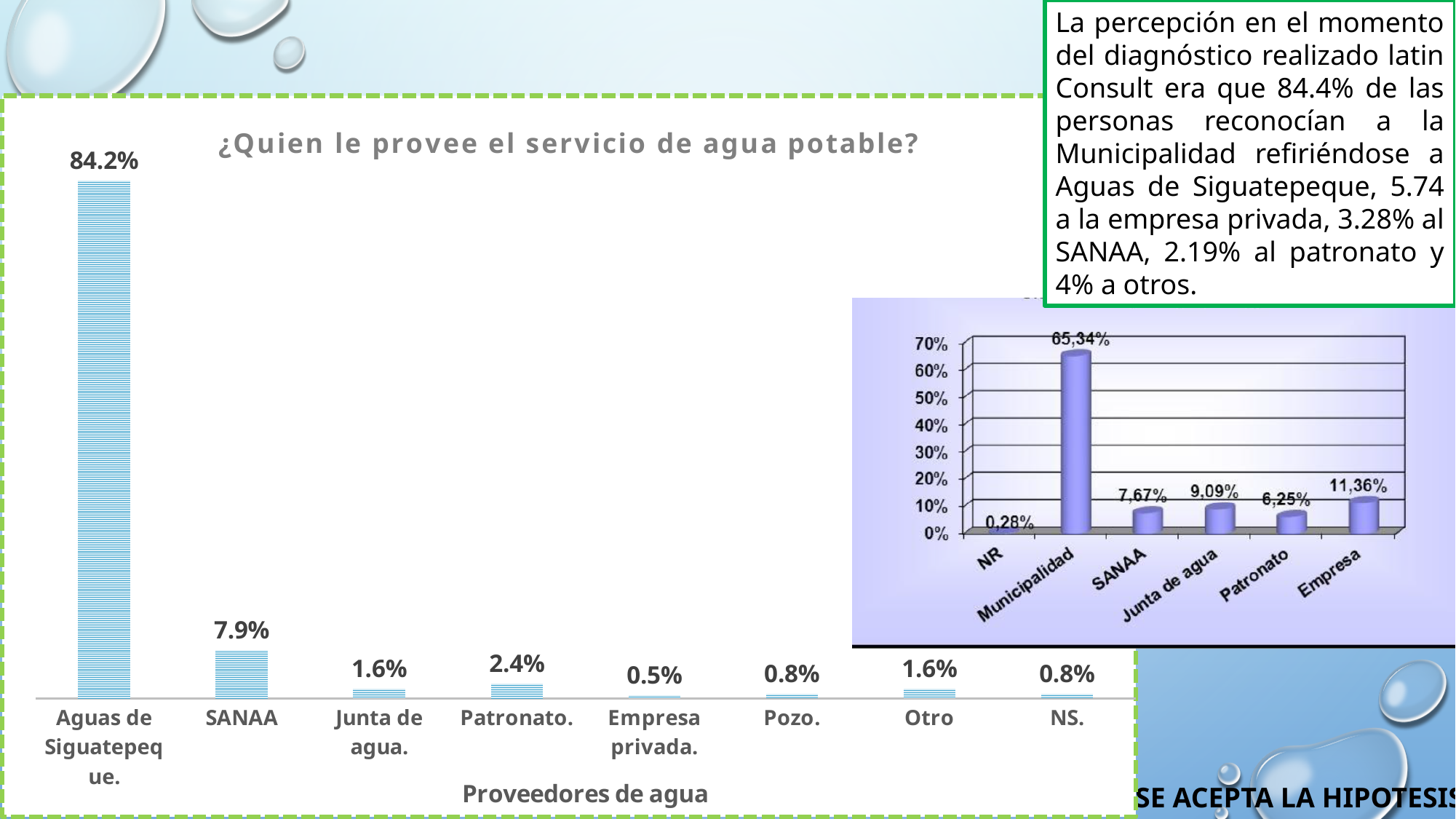
In the inset chart on the right side of the slide, what is the value for Empresa? 11,36% In the inset chart on the right side of the slide, which category has the lowest value? NR In the chart titled '¿Quien le provee el servicio de agua potable?', what is the value for Patronato? 2.4% In the chart titled '¿Quien le provee el servicio de agua potable?', what is the difference between the values for Aguas de Siguatepeque and SANAA? 76.3% In the chart titled '¿Quien le provee el servicio de agua potable?', what is the value for SANAA? 7.9% In the chart titled '¿Quien le provee el servicio de agua potable?', which category has the lowest value? Empresa privada. In the inset chart on the right side of the slide, what is the value for Municipalidad? 65,34% What kind of chart is the inset chart on the right side of the slide? Bar chart In the chart titled '¿Quien le provee el servicio de agua potable?', what is the x-axis title? Proveedores de agua In the chart titled '¿Quien le provee el servicio de agua potable?', how many categories are shown on the x axis? 8 In the chart titled '¿Quien le provee el servicio de agua potable?', what is the value for Aguas de Siguatepeque? 84.2% In the chart titled '¿Quien le provee el servicio de agua potable?', which is larger, the value for Patronato or the value for Junta de agua? Patronato.